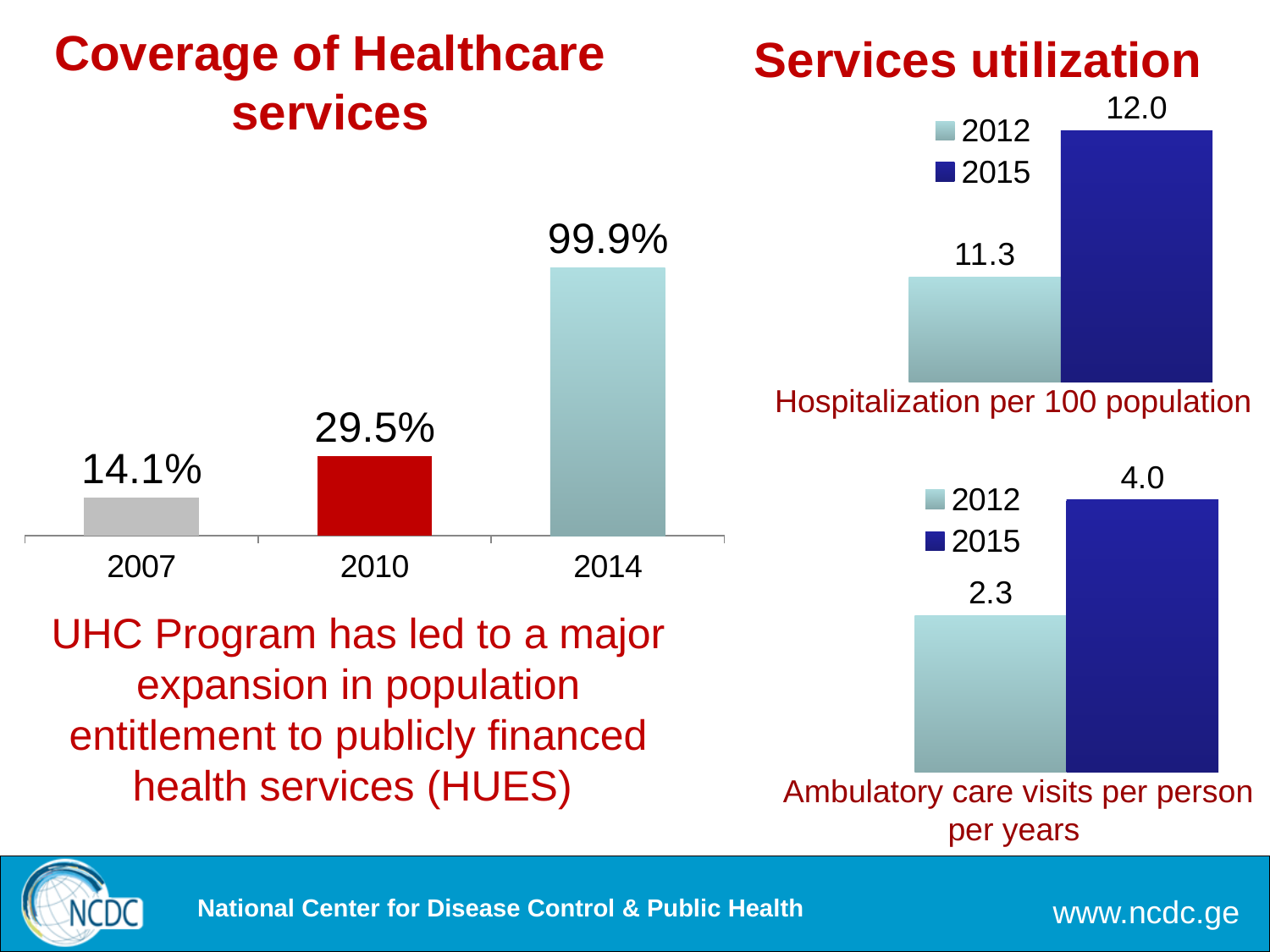
In the 'Ambulatory care visits per person per years' chart, how many series does the legend list? 2 In the 'Coverage of Healthcare services' chart, which year has the lowest value? 2007 What kind of chart is the 'Coverage of Healthcare services' chart? bar chart In the 'Coverage of Healthcare services' chart, what is the difference between the 2014 and 2010 values? 70.4% In the 'Coverage of Healthcare services' chart, do the values rise or fall from 2007 to 2014? rise In the 'Ambulatory care visits per person per years' chart, what is the value for 2015? 4.0 In the 'Hospitalization per 100 population' chart, what is the value for 2012? 11.3 In the 'Coverage of Healthcare services' chart, what is the value for 2007? 14.1% In the 'Coverage of Healthcare services' chart, what is the value for 2010? 29.5% In the 'Hospitalization per 100 population' chart, what is the difference between the 2015 and 2012 values? 0.7 In the 'Coverage of Healthcare services' chart, how many years are shown on the x axis? 3 In the 'Coverage of Healthcare services' chart, which year has the highest value? 2014